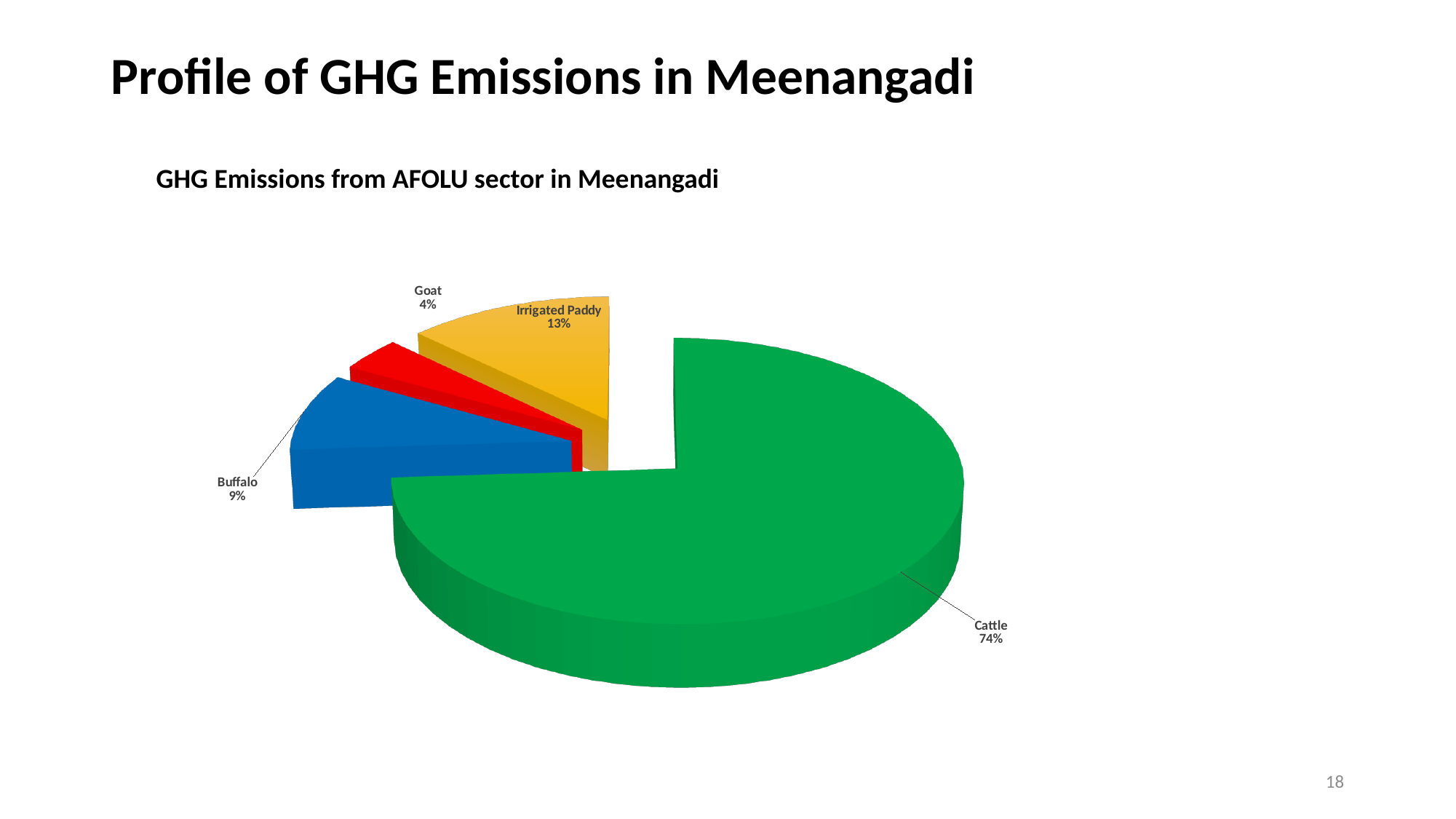
What share of GHG emissions from the AFOLU sector comes from Buffalo? 9% What share of GHG emissions from the AFOLU sector comes from Goat? 4% What share of GHG emissions from the AFOLU sector comes from Cattle? 74% What colour is the Cattle slice? Green Which category accounts for the smallest share of emissions? Goat Which category accounts for the largest share of emissions? Cattle What is the difference in percentage points between the Cattle share and the Irrigated Paddy share? 61 Which has a larger share, Buffalo or Irrigated Paddy? Irrigated Paddy What is the title of the chart? GHG Emissions from AFOLU sector in Meenangadi What type of chart is shown on the slide? Pie chart How many categories are shown in the pie chart? 4